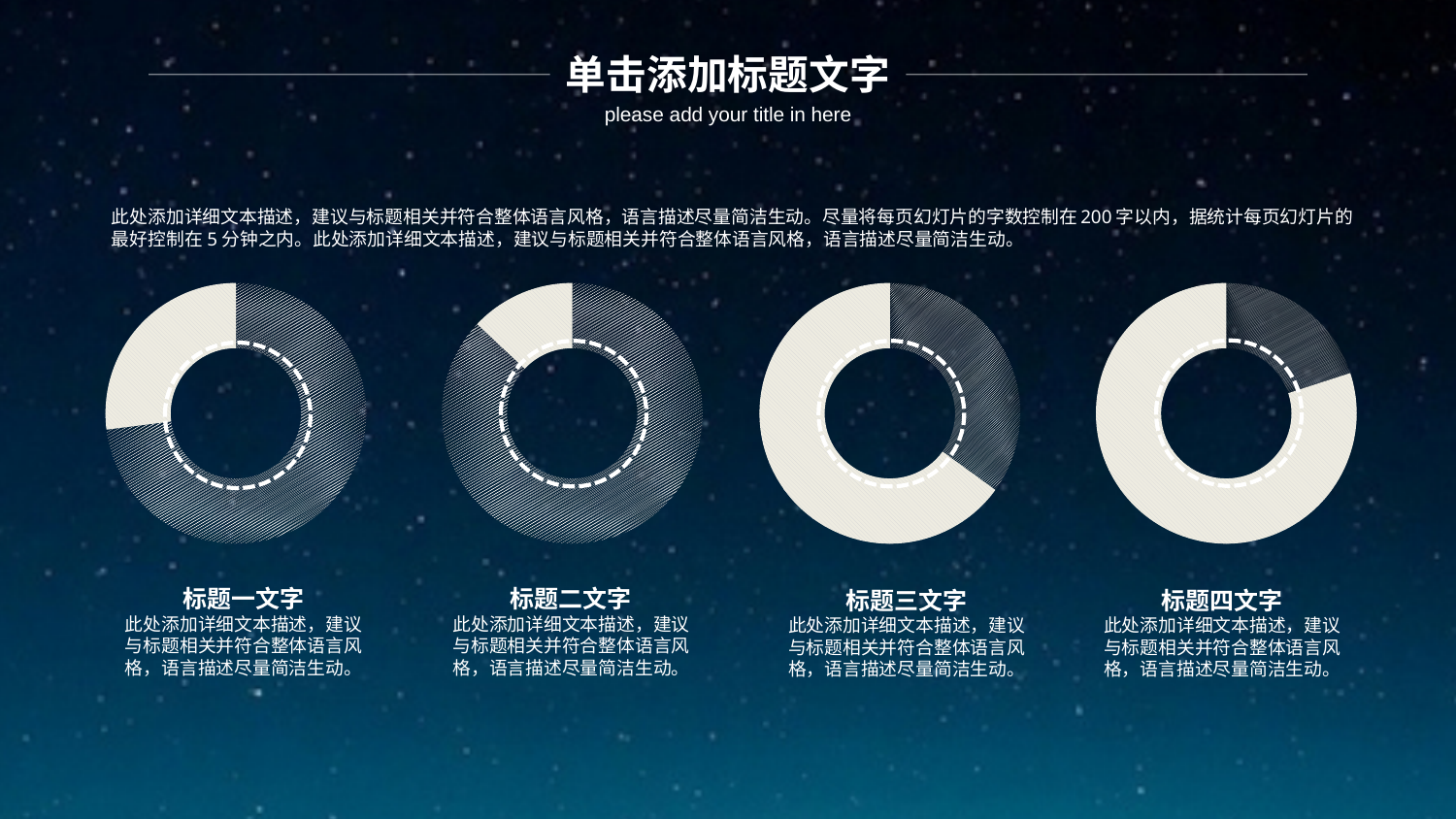
How many donut charts are on the slide? 4 In the donut chart under 标题二文字, which slice is larger, the light slice or the dark striped slice? The dark striped slice Which of the four donut charts has the smallest dark striped slice? 标题四文字 What is the label under the third donut chart from the left? 标题三文字 In the donut chart under 标题三文字, which slice is larger, the light slice or the dark striped slice? The light slice Which of the four donut charts has the largest dark striped slice? 标题二文字 How many slices does the donut chart under 标题二文字 have? 2 What is the title text at the top of the slide above the charts? 单击添加标题文字 In the donut chart under 标题四文字, which slice is larger, the light slice or the dark striped slice? The light slice What kind of chart is shown under 标题一文字? Donut chart Which of the four donut charts has the smallest light slice? 标题二文字